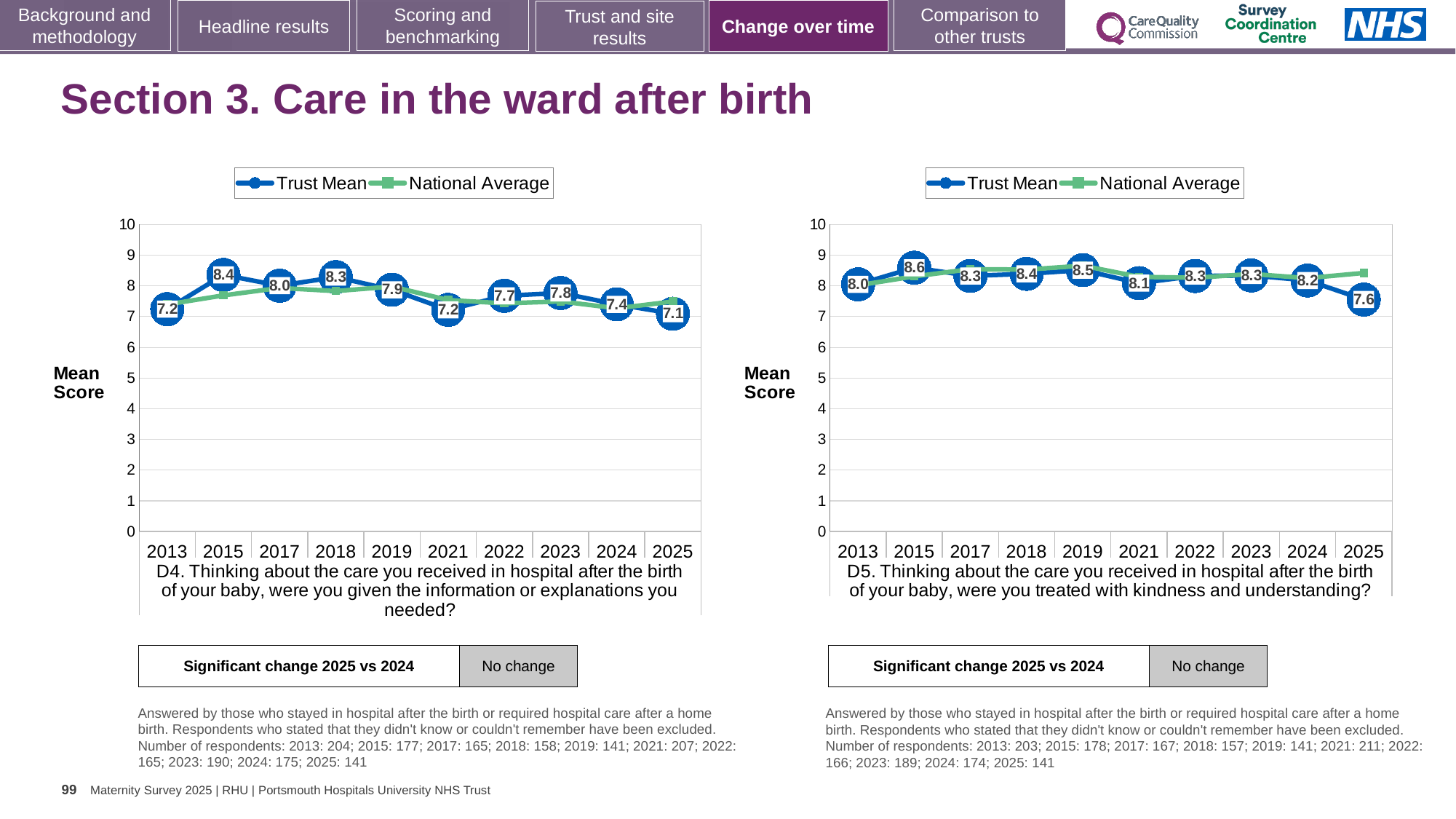
In the D4 chart (left), what is the difference between the Trust Mean scores for 2015 and 2025? 1.3 In the D4 chart (left), what is the Trust Mean score for 2025? 7.1 How many series does the legend of the D5 chart (right) list? 2 In the D5 chart (right), is the Trust Mean score for 2024 or 2025 larger? 2024 In the D5 chart (right), what is the difference between the Trust Mean scores for 2024 and 2025? 0.6 In the D4 chart (left), what is the Trust Mean score for 2015? 8.4 How many years are shown on the x axis of the D4 chart (left)? 10 In the D5 chart (right), what is the Trust Mean score for 2019? 8.5 In the D5 chart (right), which year has the lowest Trust Mean score? 2025 In the D4 chart (left), which year has the highest Trust Mean score? 2015 In the D4 chart (left), which year has the lowest Trust Mean score? 2025 In the D5 chart (right), which year has the highest Trust Mean score? 2015